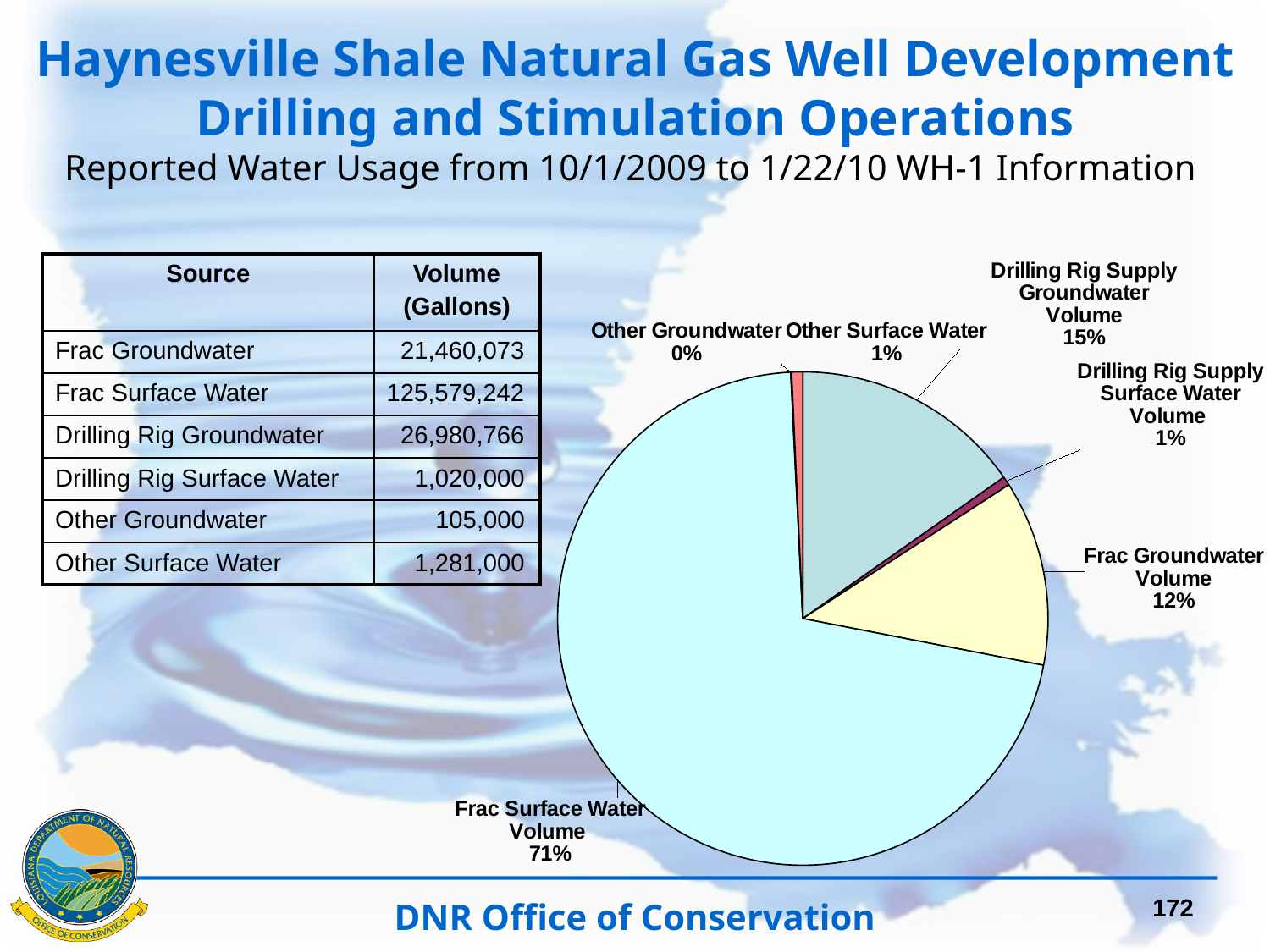
Which slice of the pie chart is the smallest? Other Groundwater What is the difference in percentage points between Frac Surface Water Volume and Frac Groundwater Volume in the pie chart? 59 What kind of chart is shown on the slide? Pie chart Which slice of the pie chart is the largest? Frac Surface Water Volume What share of the pie does Drilling Rig Supply Groundwater Volume represent? 15% What is the combined share of Frac Surface Water Volume and Frac Groundwater Volume in the pie chart? 83% Which is larger in the pie chart, Drilling Rig Supply Groundwater Volume or Frac Groundwater Volume? Drilling Rig Supply Groundwater Volume What percentage is shown for Other Groundwater in the pie chart? 0% What share of the pie does Frac Surface Water Volume represent? 71% How many slices are labelled in the pie chart? 6 What share of the pie does Frac Groundwater Volume represent? 12% What percentage is shown for Drilling Rig Supply Surface Water Volume in the pie chart? 1%